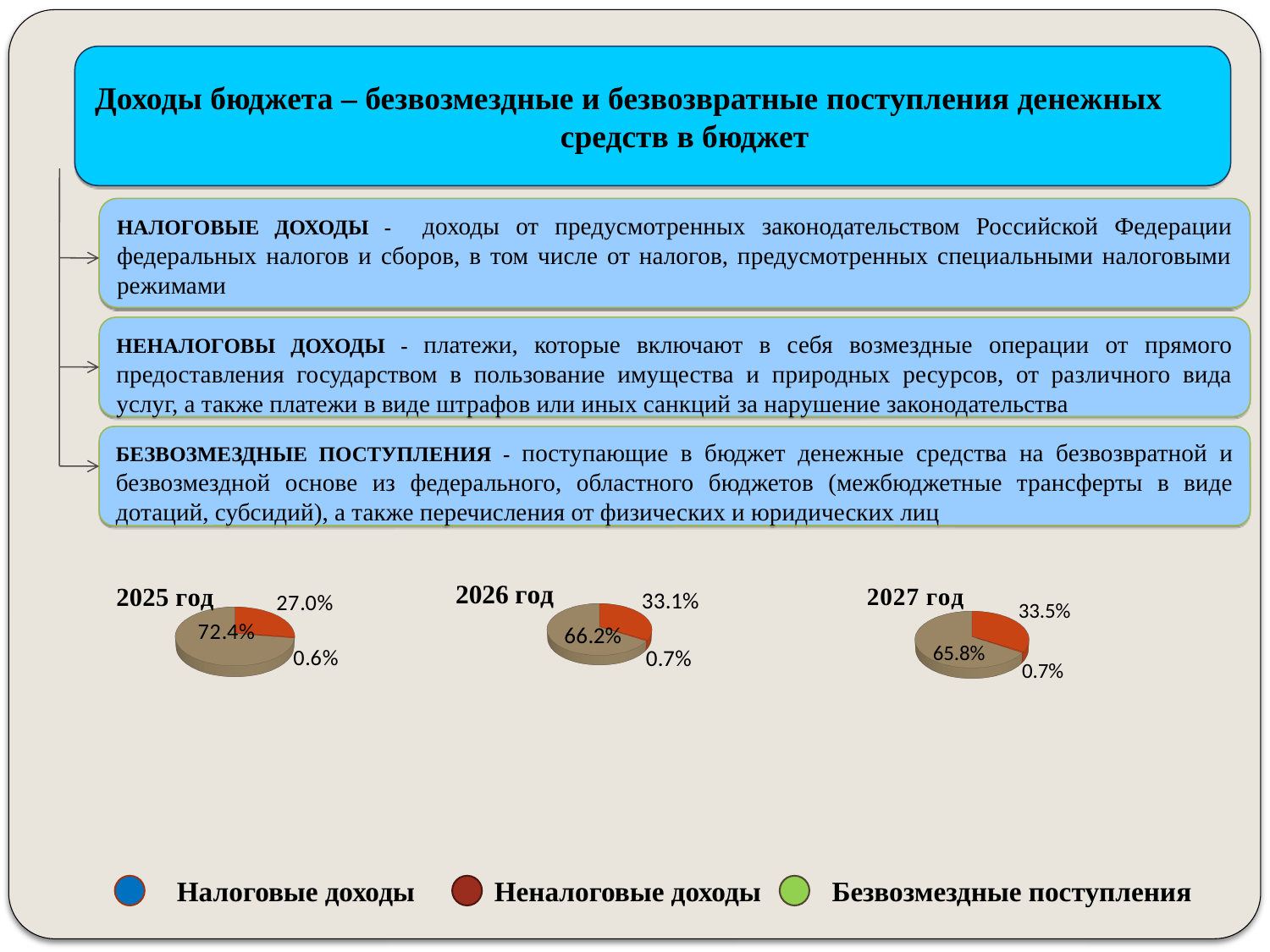
In the 2025 год pie chart, what is the value of the smallest slice? 0.6% Does the value of the largest slice rise or fall from the 2025 год chart to the 2027 год chart? fall In the 2026 год pie chart, what value is labelled on the orange-red slice? 33.1% What kind of charts are shown at the bottom of the slide? pie charts In the 2027 год pie chart, what is the value of the smallest slice? 0.7% In the 2025 год pie chart, what is the value of the largest slice? 72.4% In the 2026 год pie chart, what is the value of the largest slice? 66.2% In the 2027 год pie chart, what value is labelled on the orange-red slice? 33.5% How many slices does the 2025 год pie chart have? 3 In the 2025 год pie chart, what is the difference between the largest slice (72.4%) and the second-largest slice (27.0%)? 45.4% How many pie charts are on the slide? 3 Which is larger: the orange-red slice in the 2026 год chart (33.1%) or the orange-red slice in the 2027 год chart (33.5%)? 2027 год (33.5%)